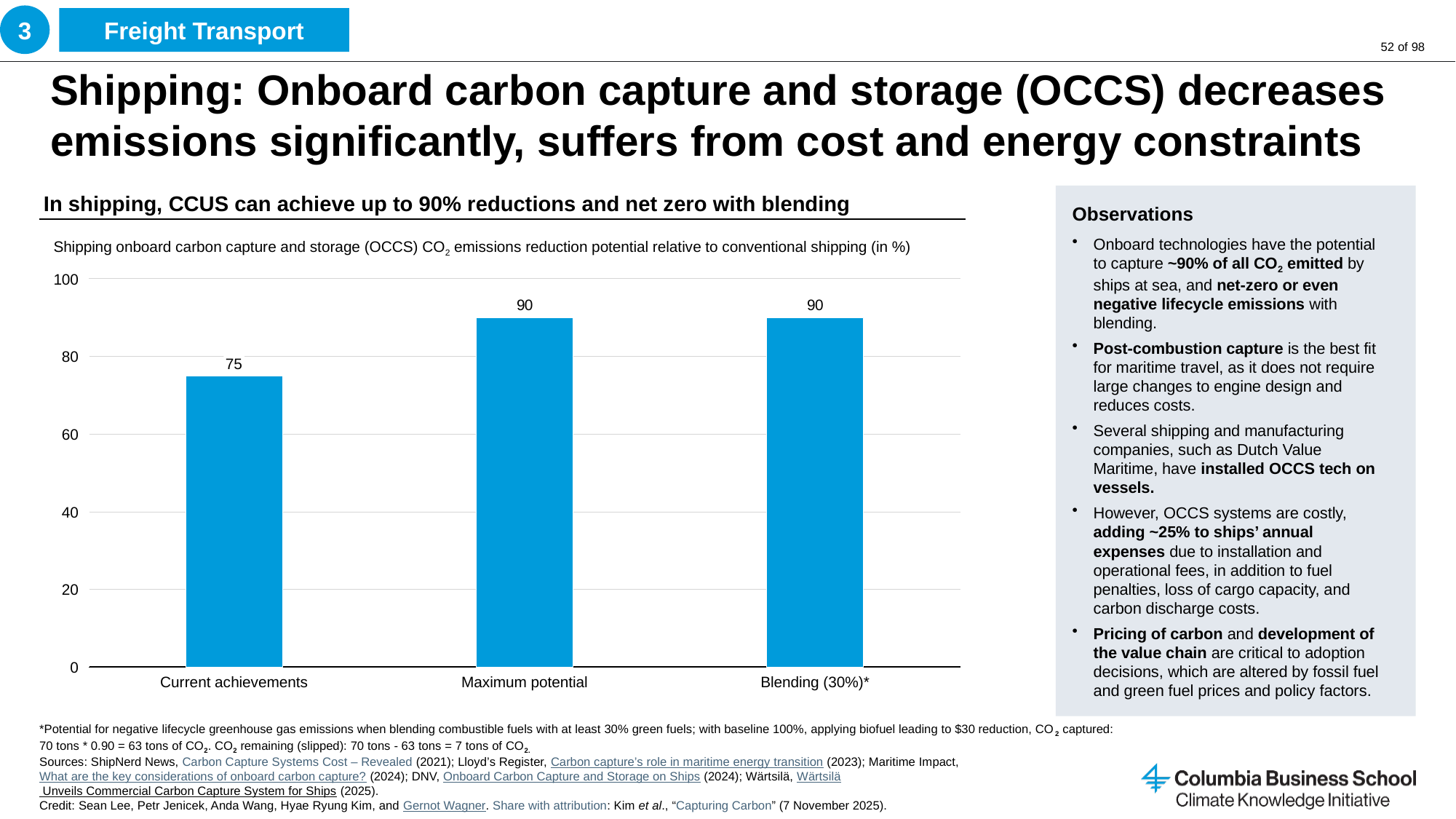
Is the value for Maximum potential greater or less than 80? greater What is the difference between the values for Maximum potential and Current achievements? 15 What is the CO2 emissions reduction potential for Current achievements? 75 What is the heading above the chart? In shipping, CCUS can achieve up to 90% reductions and net zero with blending Which is larger, the value for Current achievements or the value for Blending (30%)*? Blending (30%)* Which category has the lowest value in the chart? Current achievements What kind of chart is shown on the slide? bar chart What is the maximum value shown on the vertical axis of the chart? 100 What is the CO2 emissions reduction potential for Blending (30%)*? 90 How many categories are shown in the chart? 3 Is the value for Current achievements greater or less than 80? less What is the CO2 emissions reduction potential for Maximum potential? 90